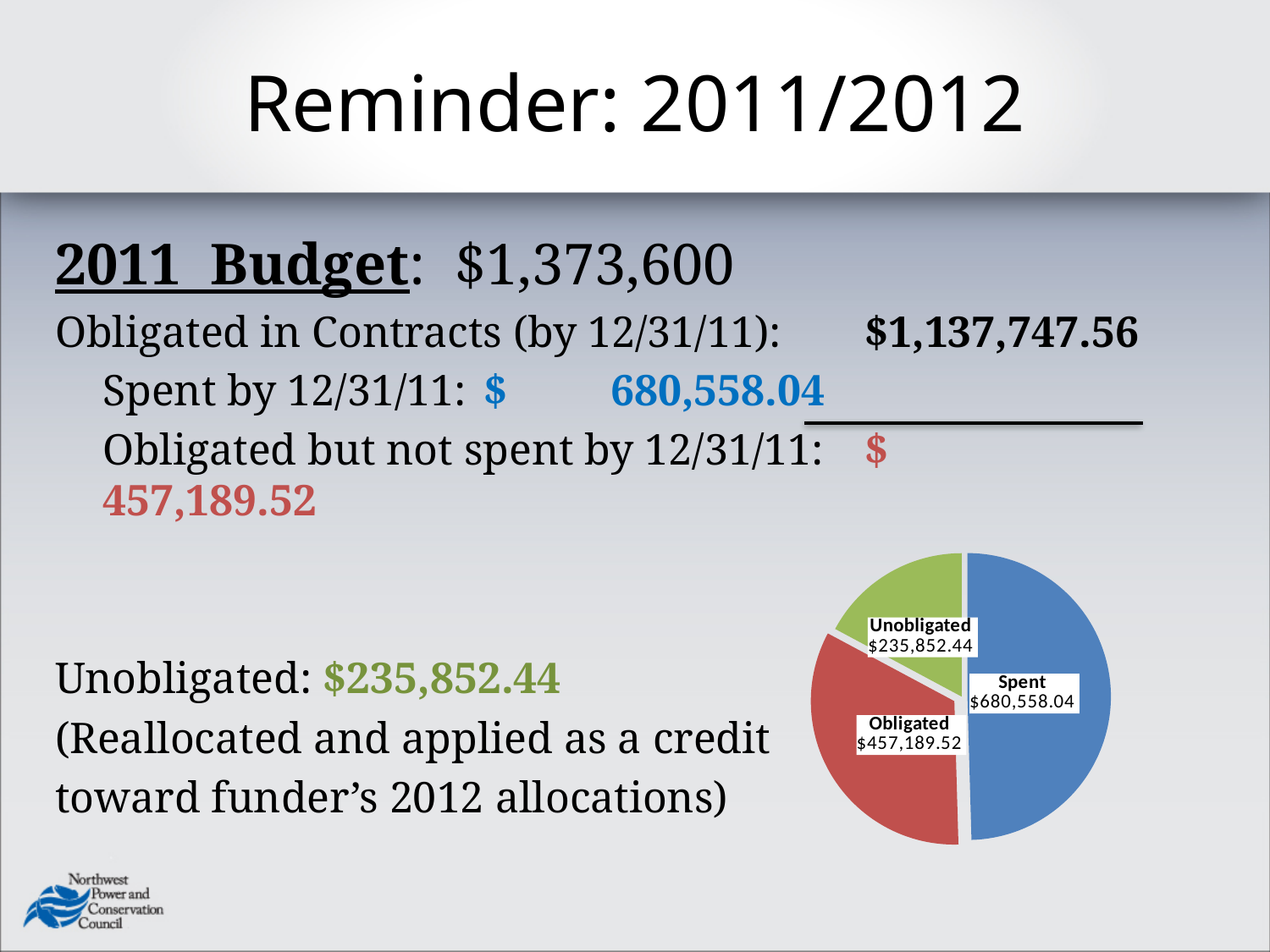
What is the value of the Obligated slice in the pie chart? $457,189.52 What is the value of the Spent slice in the pie chart? $680,558.04 What type of chart is shown on the slide? pie chart What is the difference between the Spent and Obligated values in the pie chart? $223,368.52 Which slice of the pie chart is the smallest? Unobligated What is the value of the Unobligated slice in the pie chart? $235,852.44 How many slices does the pie chart have? 3 What is the difference between the Obligated and Unobligated values in the pie chart? $221,337.08 Which is larger in the pie chart, Obligated or Unobligated? Obligated Which slice of the pie chart is the largest? Spent What is the total of all three slices in the pie chart? $1,373,600.00 What colour is the Spent slice in the pie chart? blue